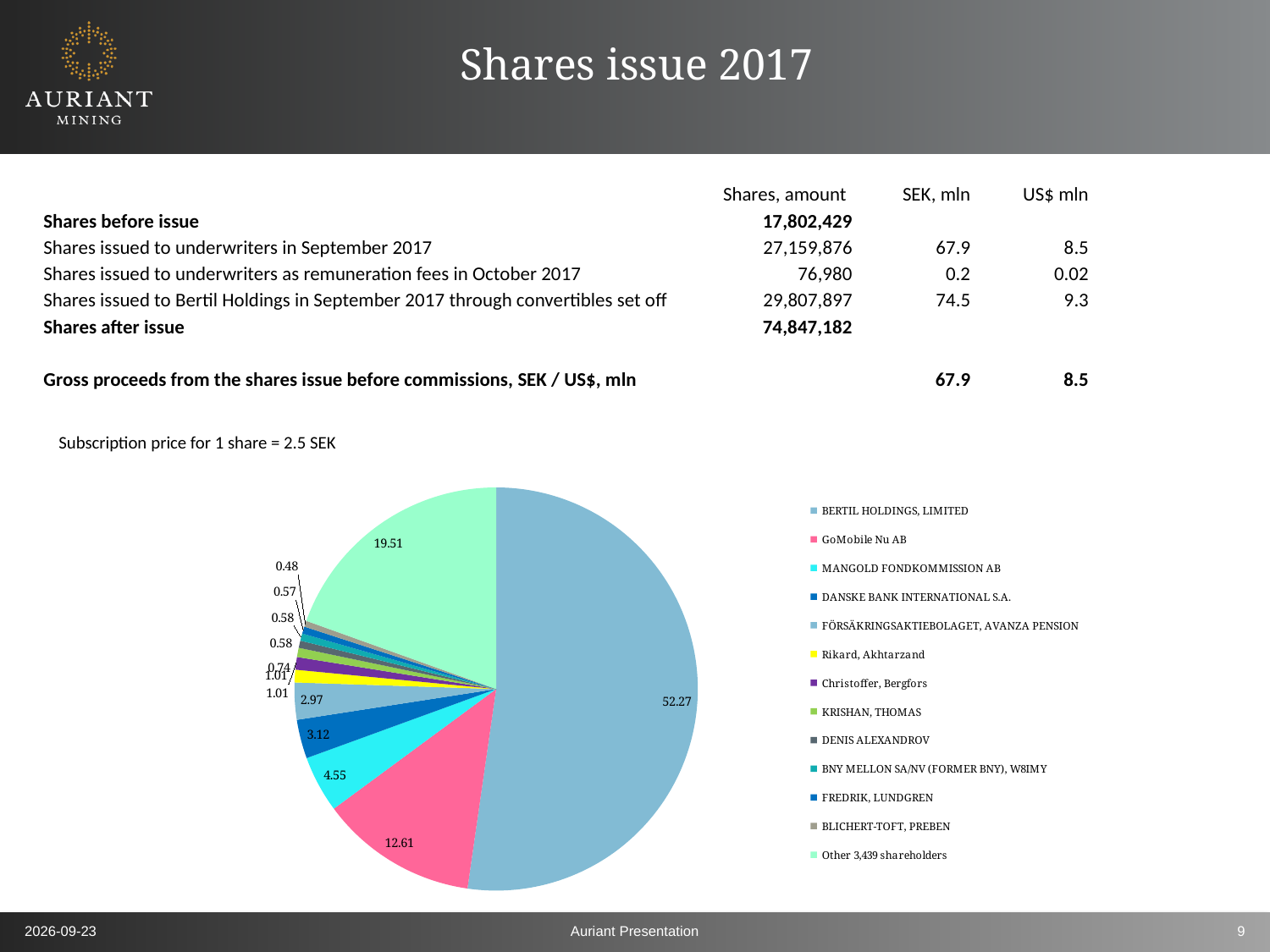
Which shareholder has the largest slice in the pie chart? BERTIL HOLDINGS, LIMITED How many entries does the legend of the pie chart list? 13 What is the value shown for BERTIL HOLDINGS, LIMITED in the pie chart? 52.27 What is the value shown for MANGOLD FONDKOMMISSION AB in the pie chart? 4.55 What is the value shown for Other 3,439 shareholders in the pie chart? 19.51 Which is larger in the pie chart: MANGOLD FONDKOMMISSION AB or FÖRSÄKRINGSAKTIEBOLAGET, AVANZA PENSION? MANGOLD FONDKOMMISSION AB What type of chart is shown on the slide? pie chart What is the difference between the values for MANGOLD FONDKOMMISSION AB and DANSKE BANK INTERNATIONAL S.A. in the pie chart? 1.43 What is the value shown for DANSKE BANK INTERNATIONAL S.A. in the pie chart? 3.12 Which is larger in the pie chart: GoMobile Nu AB or Other 3,439 shareholders? Other 3,439 shareholders What is the value shown for GoMobile Nu AB in the pie chart? 12.61 What is the difference between the values for BERTIL HOLDINGS, LIMITED and GoMobile Nu AB in the pie chart? 39.66